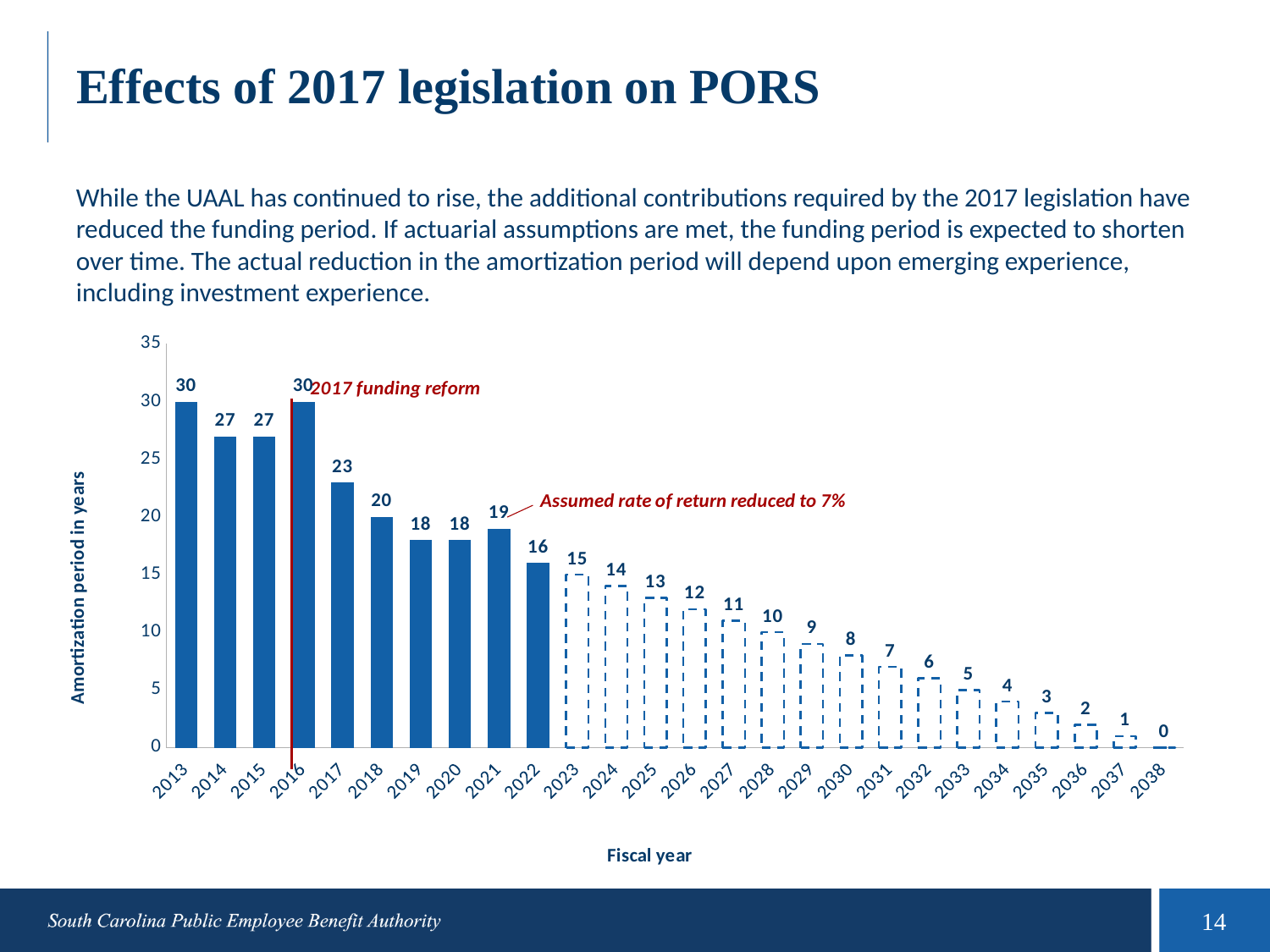
Which fiscal year has the lowest amortization period shown on the chart? 2038 What is the amortization period in years for fiscal year 2017? 23 From fiscal year 2023 to fiscal year 2038, do the amortization period values rise or fall? fall How many fiscal years are shown on the x axis of the chart? 26 Which has a longer amortization period, fiscal year 2021 or fiscal year 2022? 2021 What kind of chart is shown on the slide? bar chart What is the amortization period in years for fiscal year 2022? 16 What is the label on the y axis of the chart? Amortization period in years What is the difference in amortization period between fiscal year 2016 and fiscal year 2017? 7 Is the amortization period for fiscal year 2019 greater or less than 20? less What event does the vertical red line on the chart mark? 2017 funding reform What is the amortization period in years for fiscal year 2030? 8